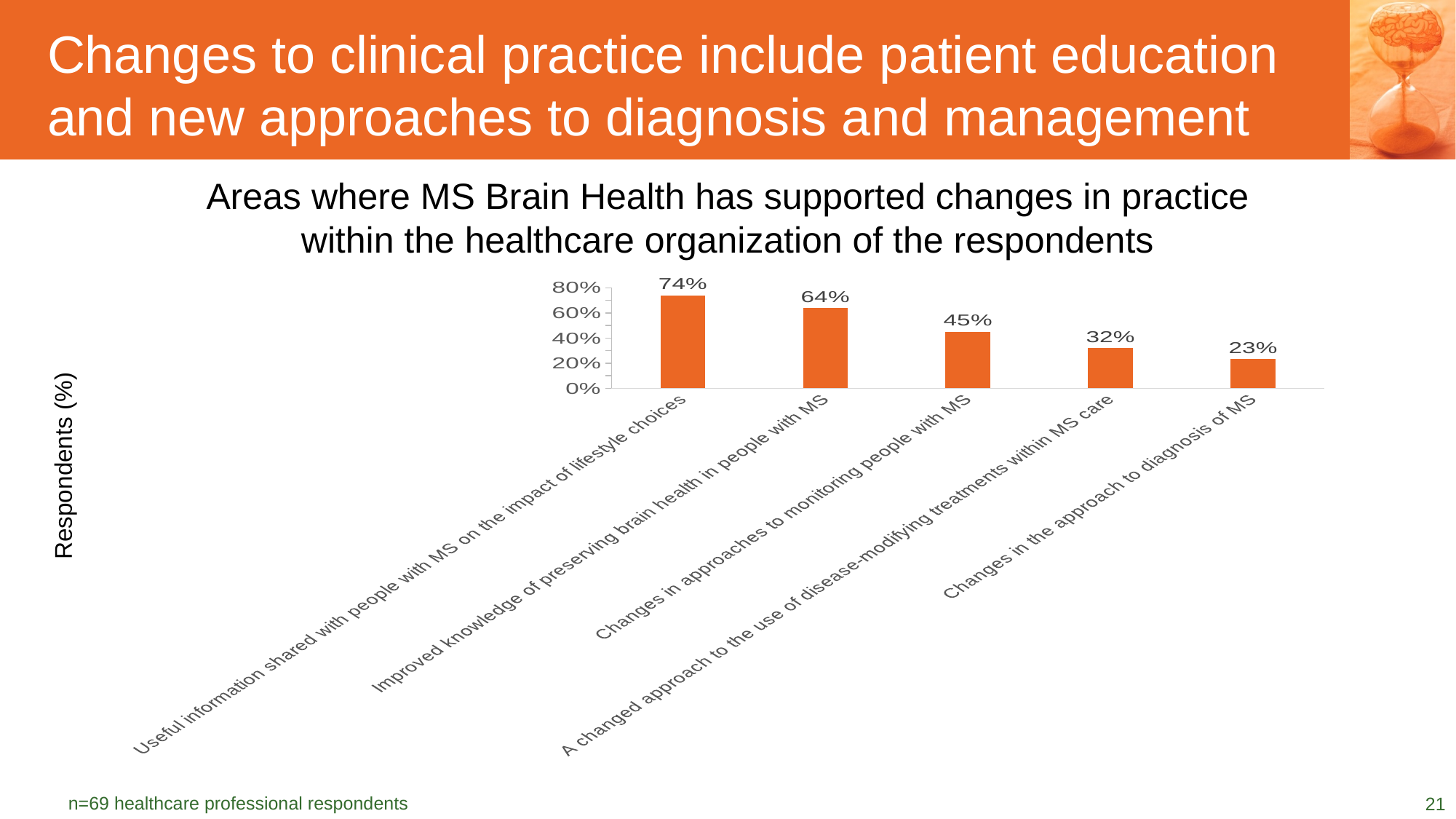
Do the values rise or fall from left to right across the categories? Fall Which category has the lowest value? Changes in the approach to diagnosis of MS What percentage of respondents selected 'Changes in approaches to monitoring people with MS'? 45% What kind of chart is shown on the slide? Bar chart Which is larger: the value for 'Changes in approaches to monitoring people with MS' or the value for 'A changed approach to the use of disease-modifying treatments within MS care'? Changes in approaches to monitoring people with MS What percentage of respondents selected 'Useful information shared with people with MS on the impact of lifestyle choices'? 74% Which category has the highest value? Useful information shared with people with MS on the impact of lifestyle choices What is the value for 'A changed approach to the use of disease-modifying treatments within MS care'? 32% What is the label of the vertical axis? Respondents (%) What is the value for 'Improved knowledge of preserving brain health in people with MS'? 64% What is the difference between the values for 'Useful information shared with people with MS on the impact of lifestyle choices' and 'Changes in the approach to diagnosis of MS'? 51% How many categories are shown in the chart? 5